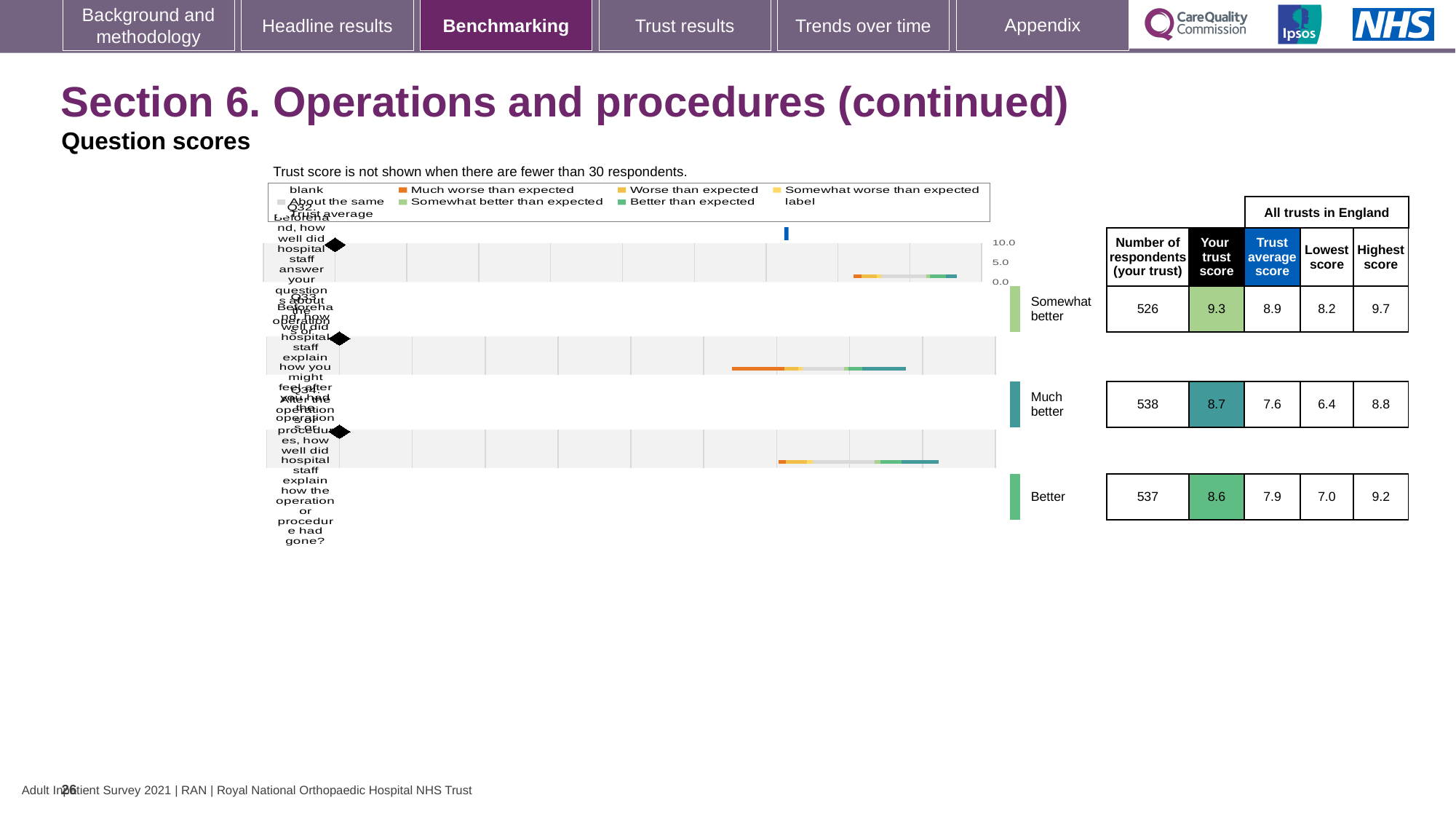
What is the trust average score for the third question row (rated 'Better')? 7.9 What is the trust score for the second question row (rated 'Much better')? 8.7 What is the trust score for the first question row (rated 'Somewhat better')? 9.3 How many questions (rows) are plotted in the chart? 3 Which question row has the lowest 'Lowest score' across all trusts in England? the second row (Much better) What is the highest score across all trusts in England for the first question row (rated 'Somewhat better')? 9.7 What kind of chart is shown on the slide? bar chart Is the trust score for the first question row larger than its trust average score? yes, 9.3 vs 8.9 What is the number of respondents for the second question row (rated 'Much better')? 538 What is the difference between the trust score and the trust average score for the second question row (rated 'Much better')? 1.1 What is the trust score for the third question row (rated 'Better')? 8.6 Which question row has the highest trust score? the first row (Somewhat better)